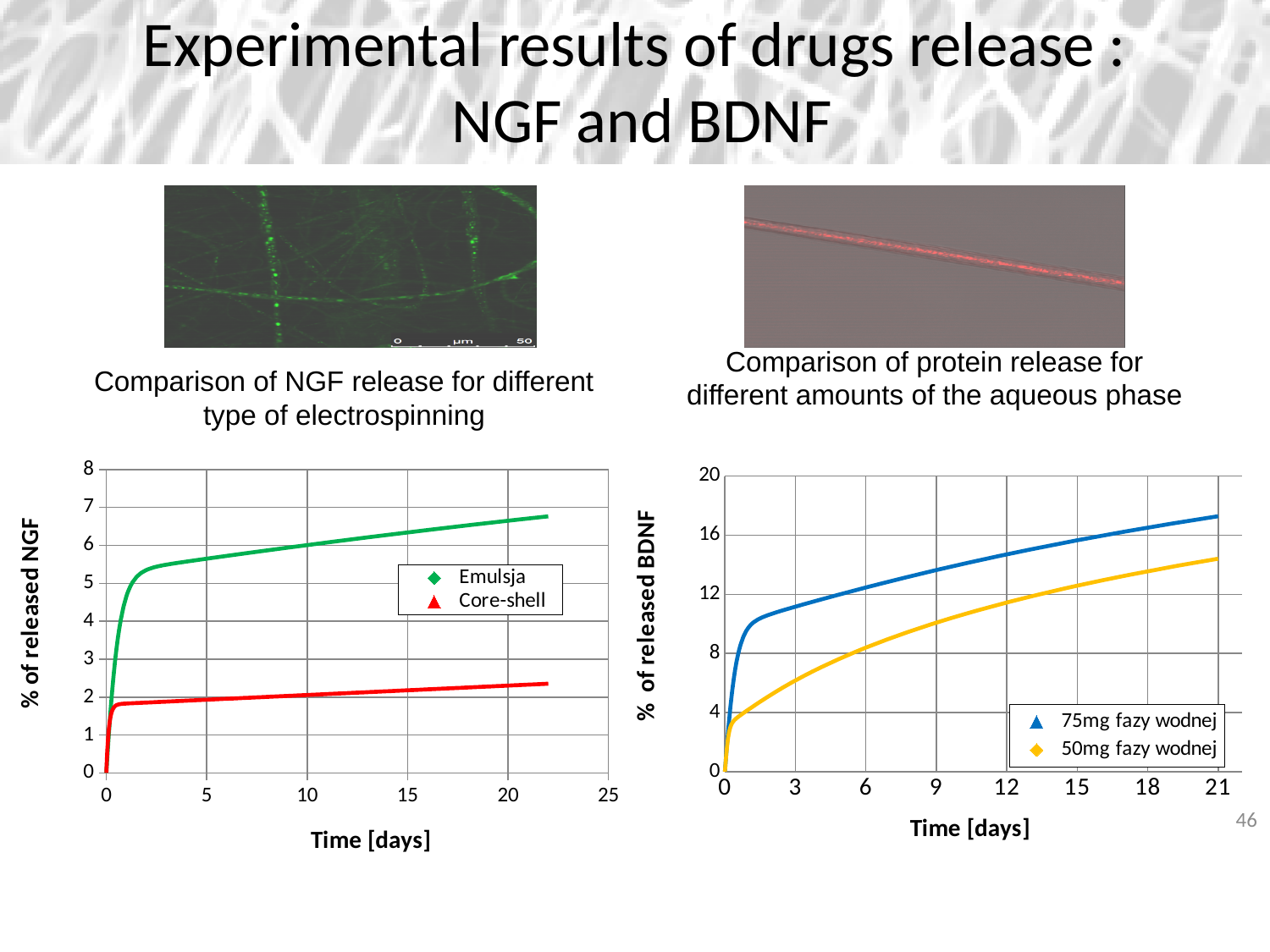
What kind of chart is the left chart, '% of released NGF' versus time? line chart In the left chart (% of released NGF), is the value for Emulsja at 20 days greater or less than 6? greater In the right chart (% of released BDNF), which series has the higher value at 12 days, 75mg fazy wodnej or 50mg fazy wodnej? 75mg fazy wodnej How many series does the legend of the right chart (% of released BDNF) list? 2 In the right chart (% of released BDNF), is the value for 50mg fazy wodnej at 21 days greater or less than 16? less In the right chart (% of released BDNF), what colour is the line for 75mg fazy wodnej? blue In the left chart (% of released NGF), is the value for Core-shell at 20 days greater or less than 3? less In the right chart (% of released BDNF), does the 50mg fazy wodnej series rise or fall as time increases? rise In the left chart (% of released NGF), which series has the higher value at 10 days, Emulsja or Core-shell? Emulsja How many series does the legend of the left chart (% of released NGF) list? 2 What is the x-axis title of the left chart (% of released NGF)? Time [days]